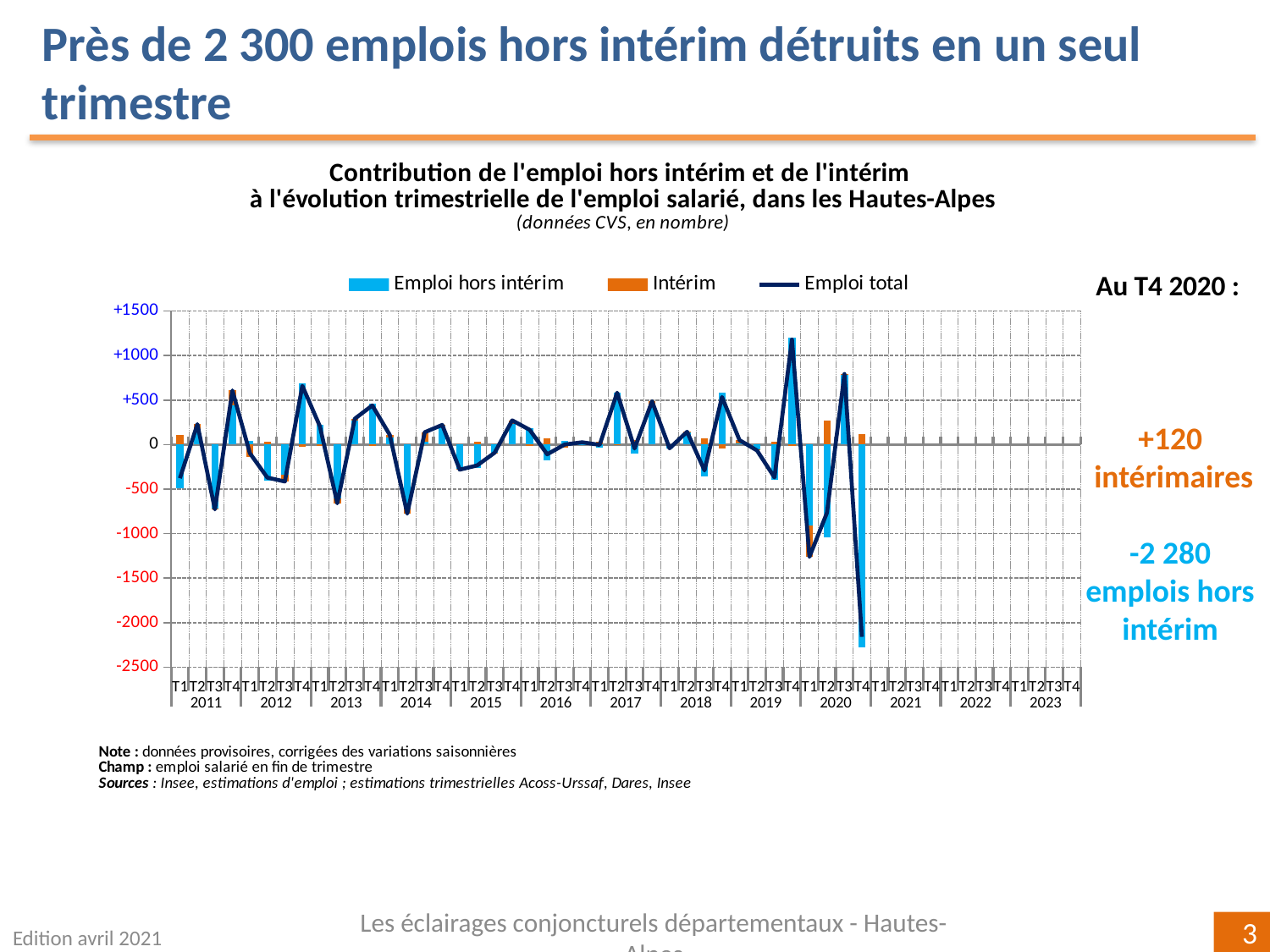
Does the Emploi total line rise or fall between T3 2020 and T4 2020? fall In which quarter does the Emploi total line reach its highest point? T4 2019 What kind of chart is shown on the slide? Combined bar and line chart According to the annotation, what is the value for Emploi hors intérim at T4 2020? -2 280 Which is lower, the Emploi hors intérim value at T1 2020 or at T4 2020? T4 2020 Is the value of Emploi hors intérim at T1 2020 greater or less than -500? less Is the value of Emploi total at T4 2020 greater or less than -2000? less How many series does the chart legend list? 3 What are the three series named in the chart legend? Emploi hors intérim, Intérim, Emploi total According to the annotation, what is the value for Intérim at T4 2020? +120 In which quarter is the Emploi hors intérim bar at its lowest? T4 2020 Is the value of Emploi total at T4 2019 greater or less than +1000? greater